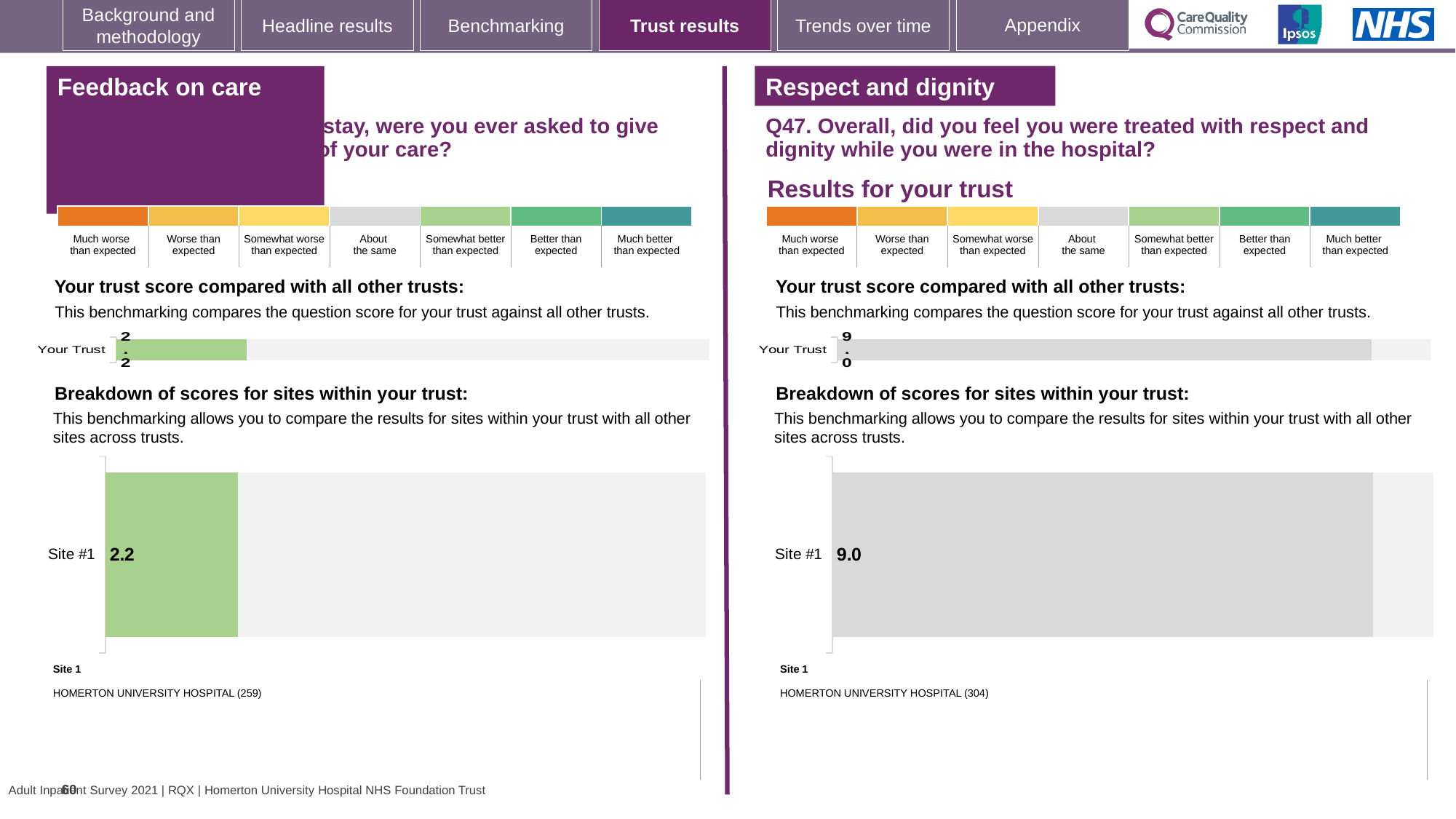
What type of chart is used for the 'Feedback on care' breakdown of scores for sites? Bar chart What colour is the Site #1 bar in the 'Feedback on care' breakdown chart? Green On the 'Feedback on care' breakdown of scores for sites chart, what is the value for Site #1? 2.2 Which section's Site #1 bar has the larger value, 'Feedback on care' or 'Respect and dignity'? Respect and dignity What colour is the Site #1 bar in the 'Respect and dignity' breakdown chart? Grey Which section's Your Trust bar has the larger value, 'Feedback on care' or 'Respect and dignity'? Respect and dignity On the 'Respect and dignity' trust score chart, what is the value shown for Your Trust? 9.0 What is the difference between the Site #1 value in the 'Respect and dignity' chart and the Site #1 value in the 'Feedback on care' chart? 6.8 On the 'Feedback on care' trust score chart, what is the value shown for Your Trust? 2.2 On the 'Respect and dignity' breakdown of scores for sites chart, what is the value for Site #1? 9.0 How many sites are plotted in the 'Feedback on care' breakdown of scores for sites chart? 1 How many sites are plotted in the 'Respect and dignity' breakdown of scores for sites chart? 1